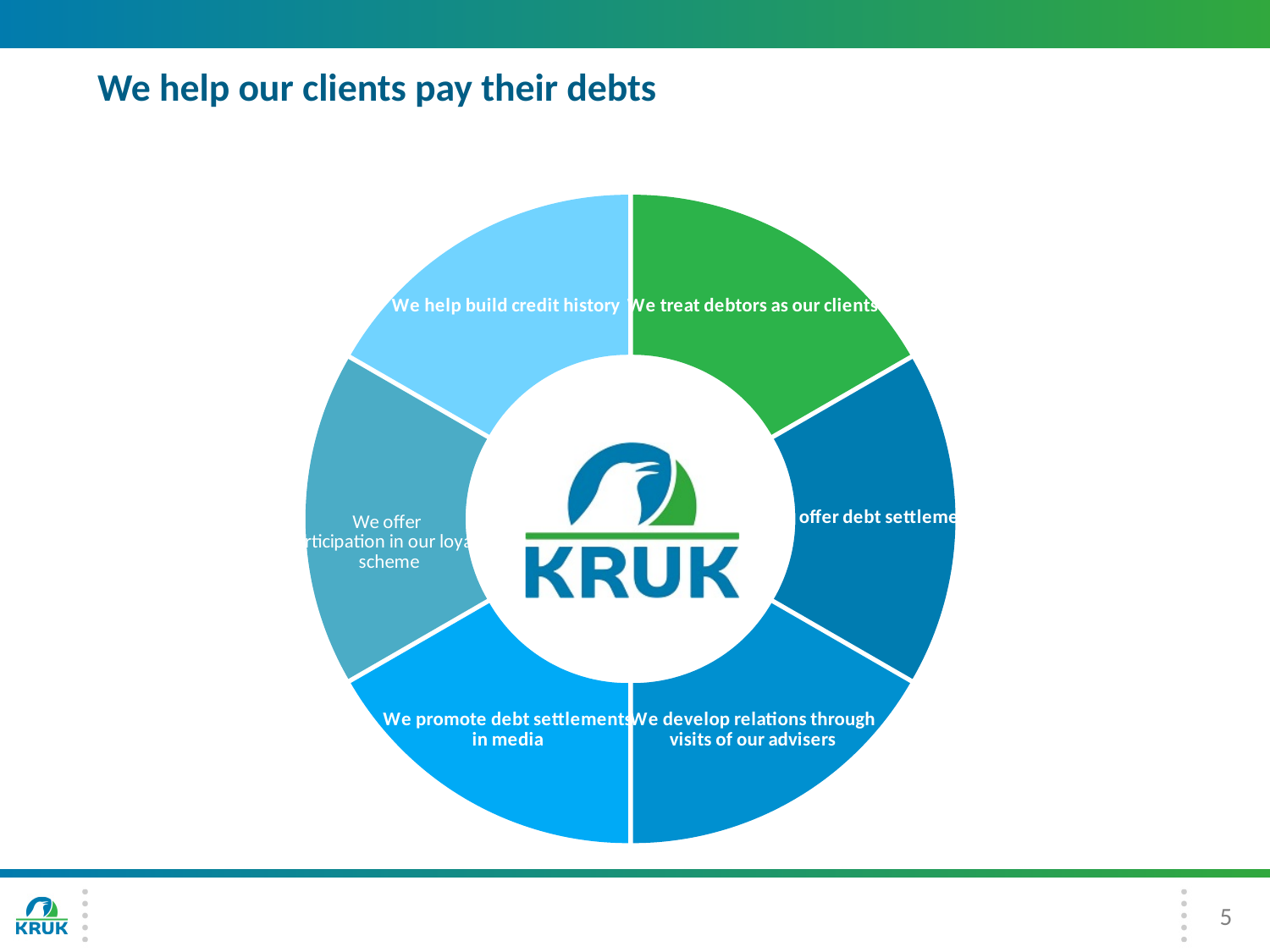
How many segments does the doughnut chart have? 6 What label appears on the segment at the bottom right of the doughnut chart? We develop relations through visits of our advisers What label appears on the light blue segment at the top left of the doughnut chart? We help build credit history What kind of chart is shown on the slide? Doughnut chart What label appears on the green segment at the top right of the doughnut chart? We treat debtors as our clients What label appears on the segment at the bottom left of the doughnut chart? We promote debt settlements in media What is the title of the slide containing the doughnut chart? We help our clients pay their debts Are the segments of the doughnut chart equal in size? Yes